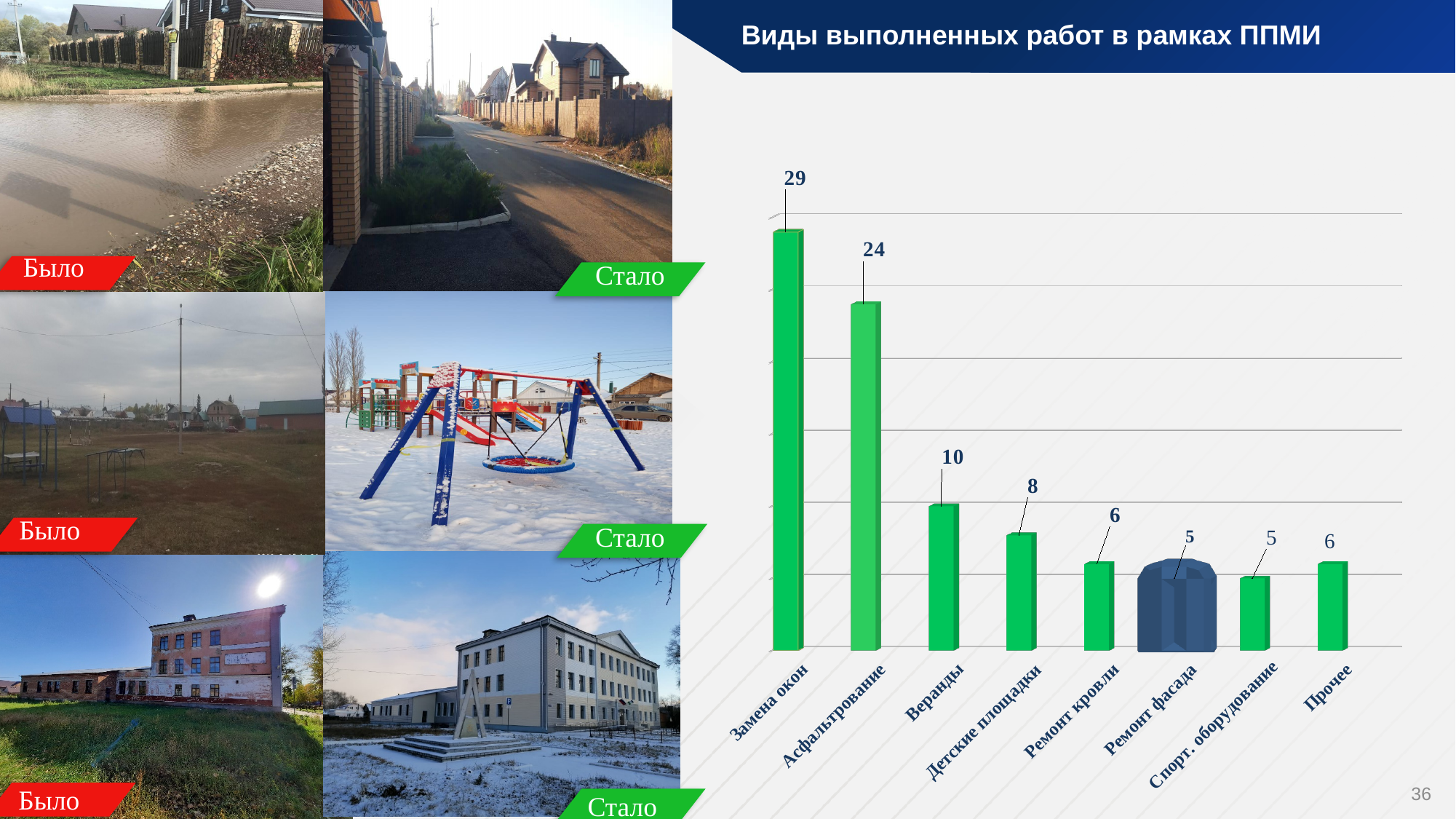
Which is larger, the value for Ремонт кровли or the value for Спорт. оборудование? Ремонт кровли What is the title of the chart? Виды выполненных работ в рамках ППМИ Which category has the highest value? Замена окон What is the value for Ремонт фасада? 5 What is the value for Детские площадки? 8 What is the difference between the values for Замена окон and Асфальтирование? 5 What is the difference between the values for Веранды and Детские площадки? 2 What kind of chart is shown on the slide? Bar chart How many categories are shown in the chart? 8 What is the value for Асфальтирование? 24 What is the value for Замена окон? 29 What is the value for Веранды? 10